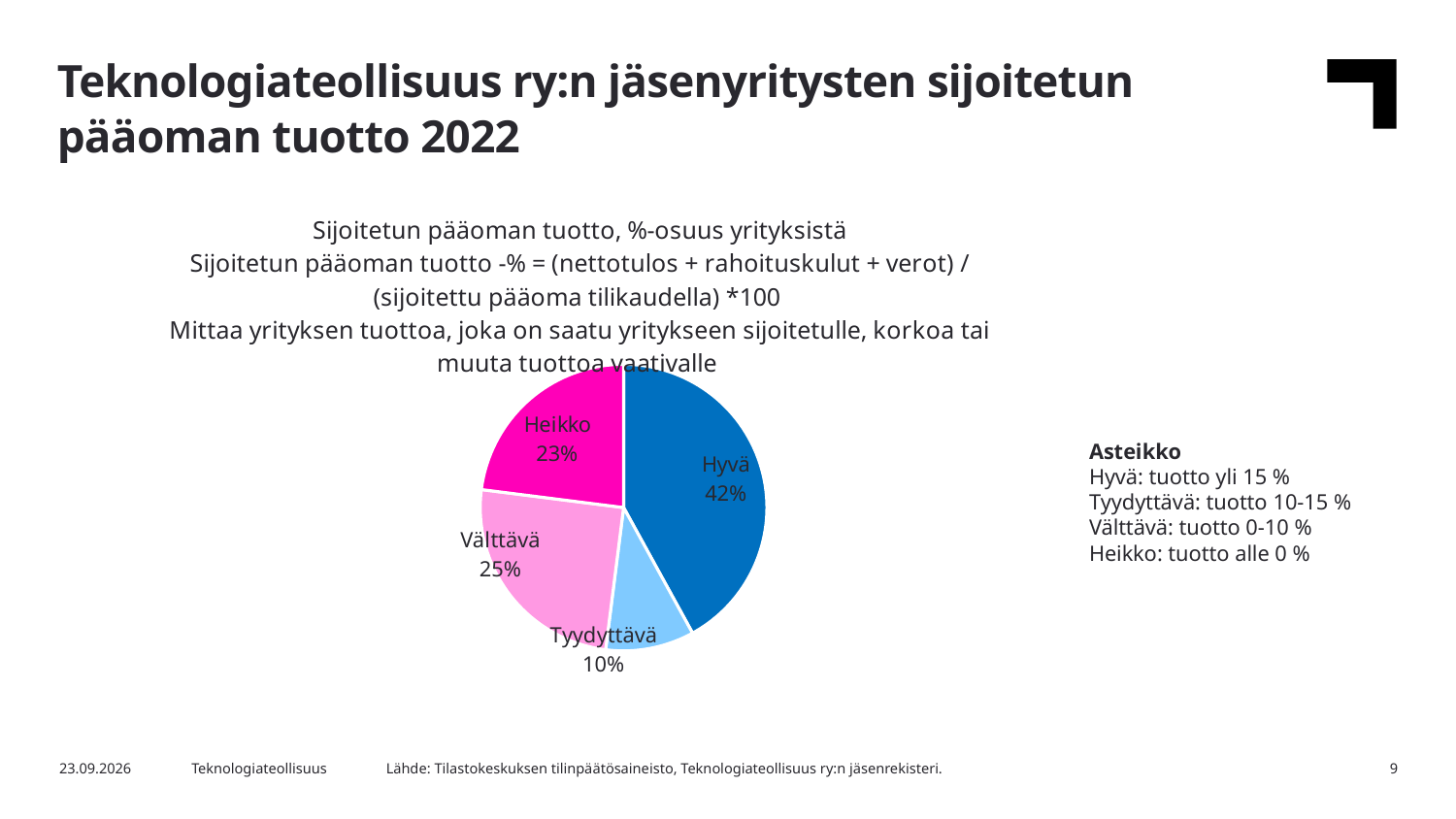
What is the difference in percentage points between the Hyvä and Heikko shares? 19 Which category has the largest share of the pie? Hyvä What share of companies falls in the Hyvä category? 42% How many categories are shown in the pie chart? 4 Which is larger, the Välttävä share or the Heikko share? Välttävä Which category has the smallest share of the pie? Tyydyttävä What share of companies falls in the Heikko category? 23% What kind of chart is shown on the slide? Pie chart What is the combined share of the Välttävä and Heikko categories? 48% What share of companies falls in the Välttävä category? 25% What share of companies falls in the Tyydyttävä category? 10% What colour is the Hyvä slice of the pie? Dark blue